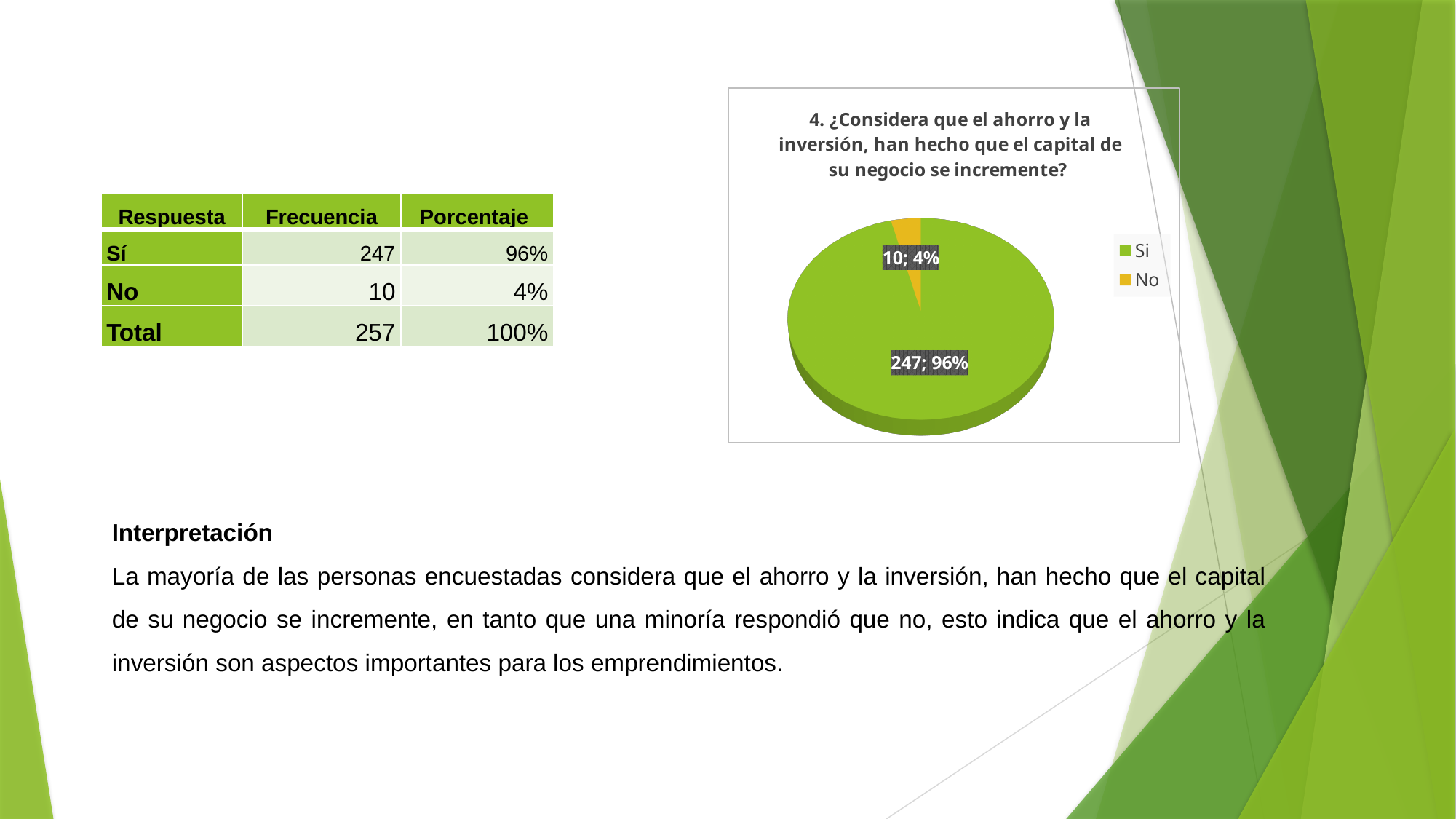
What percentage share of the pie does the 'Si' slice represent? 96% How many slices does the pie chart have? 2 What kind of chart is shown on the slide? pie chart What is the frequency value shown for the 'No' slice in the pie chart? 10 Which slice of the pie chart is the smallest? No What is the difference in frequency between the 'Si' and 'No' slices? 237 What is the frequency value shown for the 'Si' slice in the pie chart? 247 What colour is the 'No' slice in the pie chart? yellow Which slice has the larger value, 'Si' or 'No'? Si What percentage share of the pie does the 'No' slice represent? 4% How many entries does the pie chart's legend list? 2 Which slice of the pie chart is the largest? Si